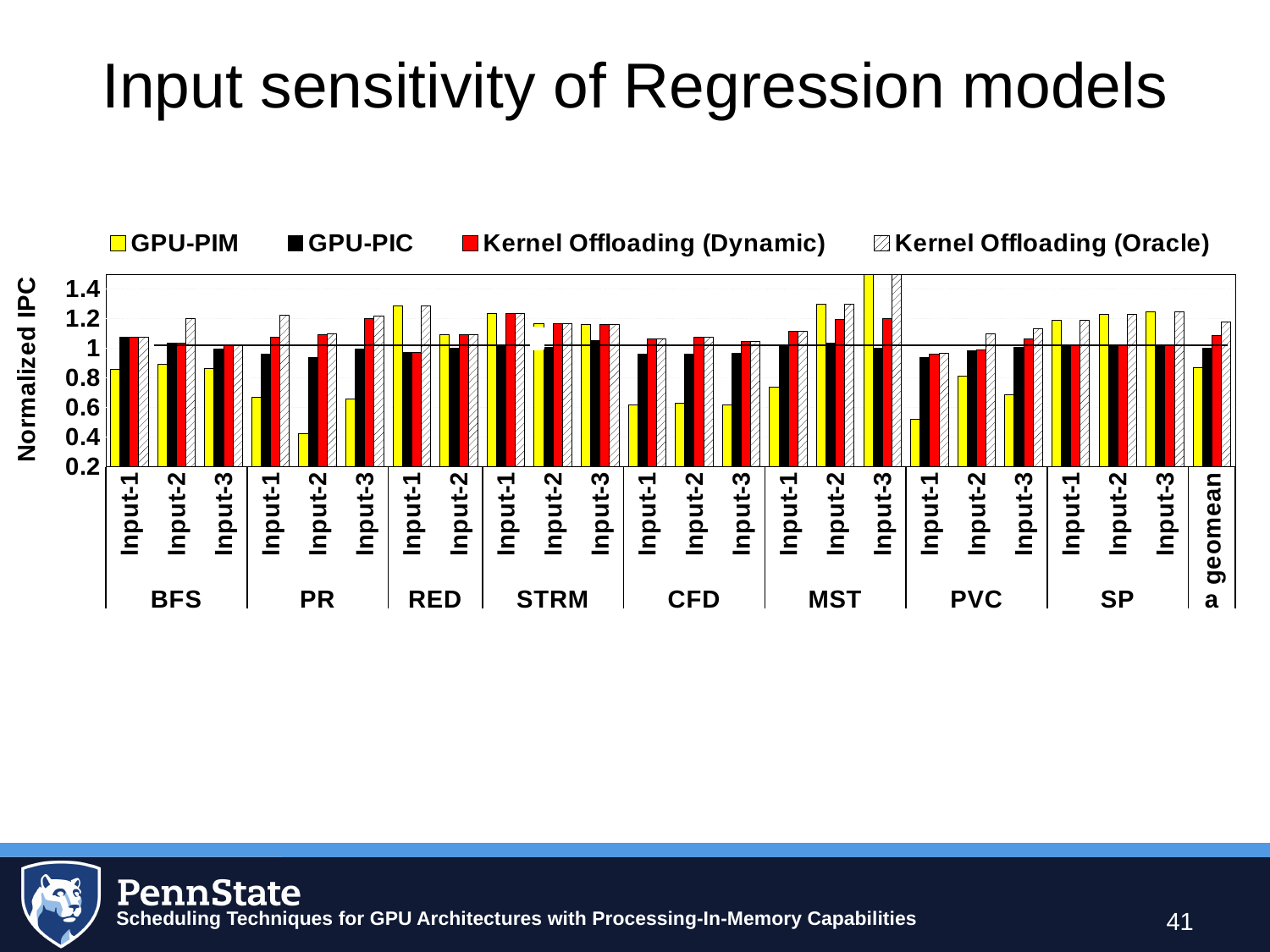
What is the label of the y axis? Normalized IPC How many input groups (bars clusters) are shown for the RED benchmark? 2 Is the GPU-PIM value for PR Input-2 greater or less than 0.6? less Which input group has the highest GPU-PIM value? MST Input-3 For PR Input-2, which is larger, the GPU-PIM value or the GPU-PIC value? GPU-PIC Is the GPU-PIM value for RED Input-1 greater or less than 1.2? greater What kind of chart is shown on the slide? bar chart For MST Input-3, which is larger, the GPU-PIM value or the GPU-PIC value? GPU-PIM Is the GPU-PIM value for MST Input-3 greater or less than 1.4? greater How many series does the legend list? 4 How many benchmark groups are shown on the x axis, not counting geomean? 8